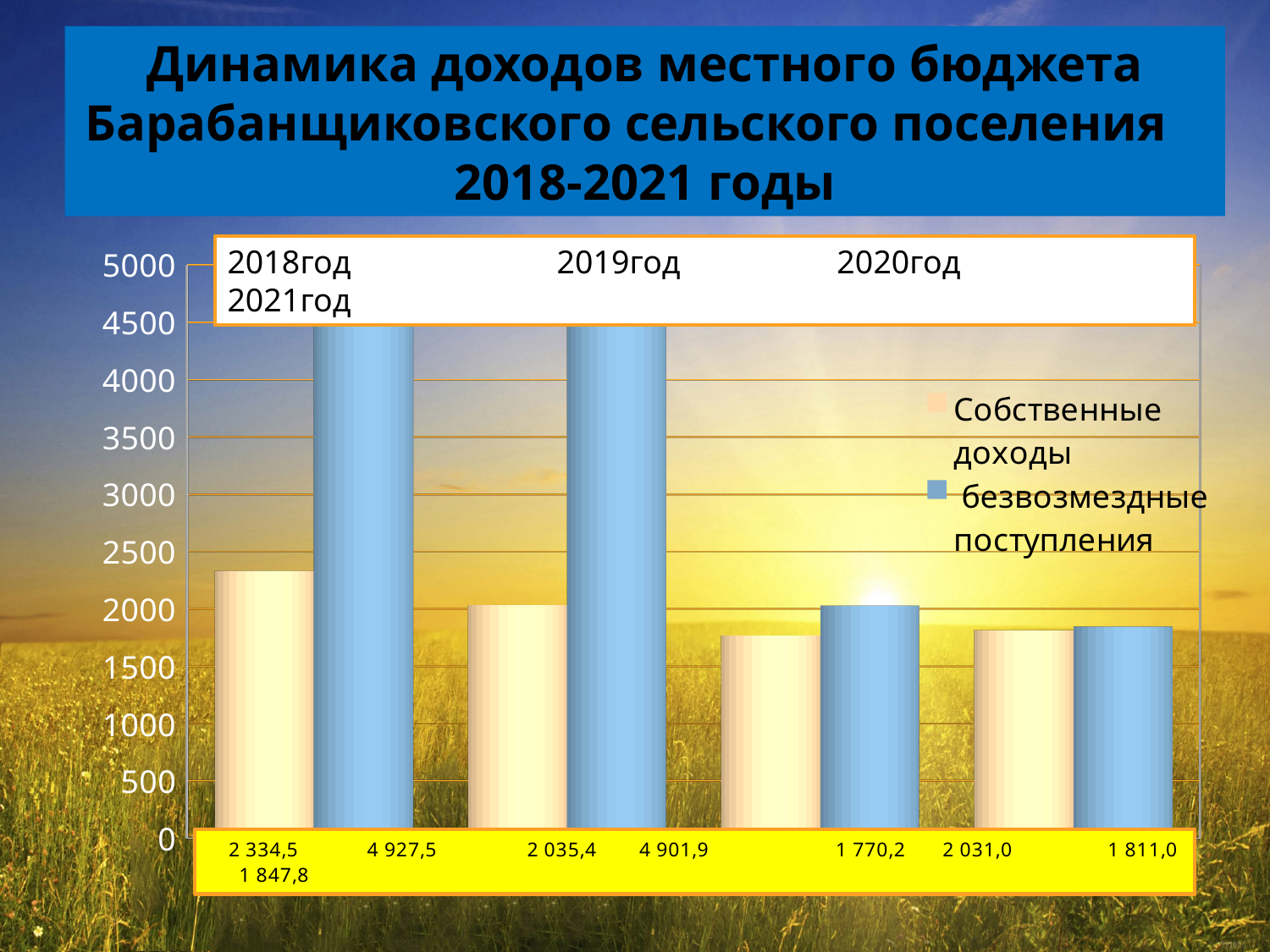
What is the value of Собственные доходы for 2020год? 1 770,2 How many years are shown on the chart? 4 What kind of chart is shown on the slide? Bar chart What is the value of безвозмездные поступления for 2018год? 4 927,5 What is the difference between безвозмездные поступления and Собственные доходы in 2018год? 2 593,0 How many series does the legend list? 2 Do the values of Собственные доходы rise or fall from 2018год to 2020год? Fall Which year has the lowest value of Собственные доходы? 2020год What is the value of Собственные доходы for 2018год? 2 334,5 What is the value of безвозмездные поступления for 2019год? 4 901,9 Is the value of Собственные доходы for 2019год greater or less than 2500? less In 2020год, which is larger: Собственные доходы or безвозмездные поступления? безвозмездные поступления